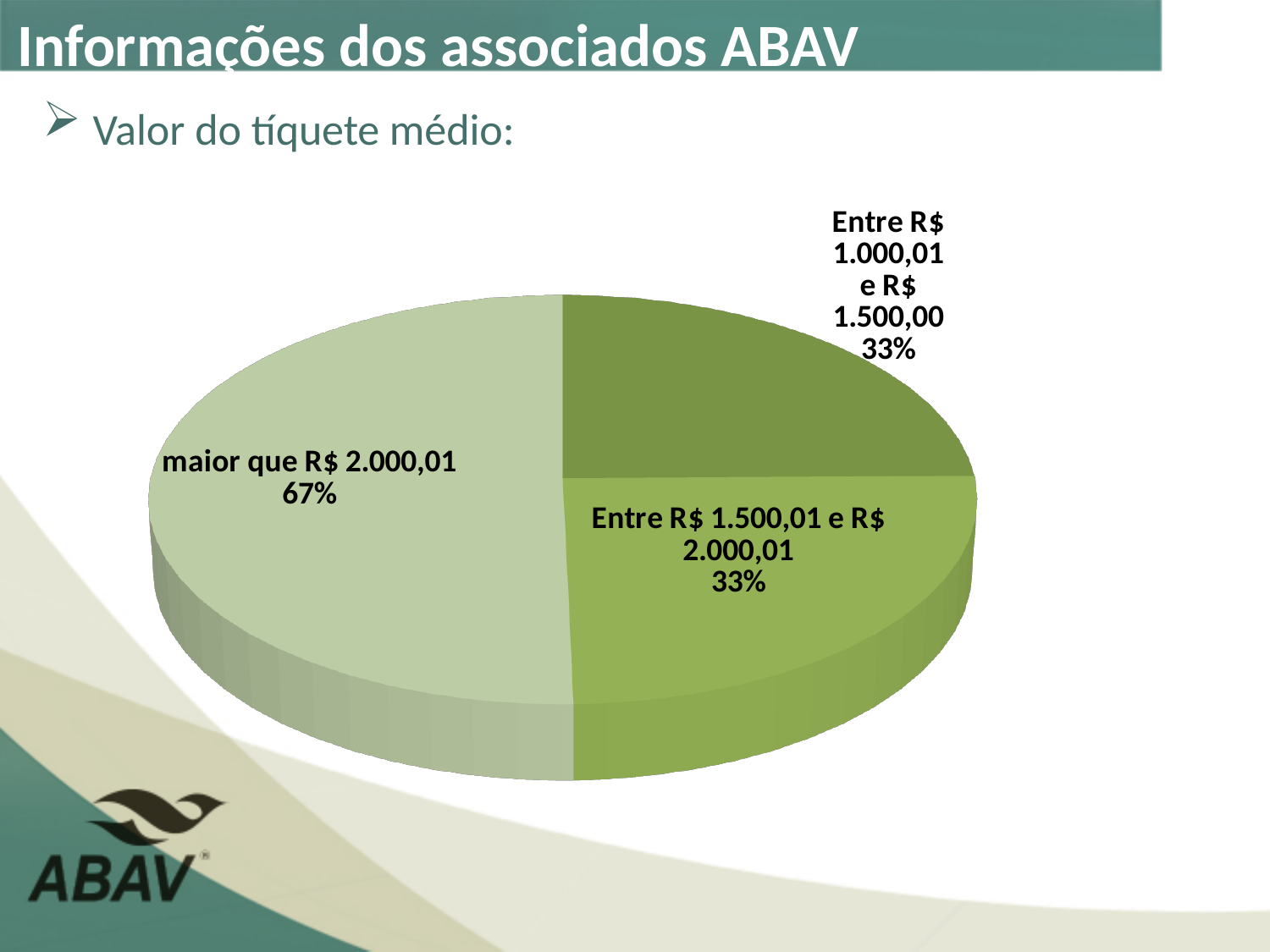
What kind of chart is shown on the slide? Pie chart Do the two 'Entre' categories show the same percentage? Yes Which is larger: the share for 'maior que R$ 2.000,01' or the share for 'Entre R$ 1.000,01 e R$ 1.500,00'? maior que R$ 2.000,01 What share of the pie does the 'maior que R$ 2.000,01' slice represent? 67% What is the chart about, according to the bullet text above it? Valor do tíquete médio What percentage is shown for the 'Entre R$ 1.000,01 e R$ 1.500,00' slice? 33% What is the difference in percentage points between the 'maior que R$ 2.000,01' slice and the 'Entre R$ 1.500,01 e R$ 2.000,01' slice? 34% How many slices does the pie chart have? 3 What percentage is shown for the 'Entre R$ 1.500,01 e R$ 2.000,01' slice? 33% Which category has the largest share of the pie? maior que R$ 2.000,01 What percentage is shown for the 'maior que R$ 2.000,01' slice? 67%